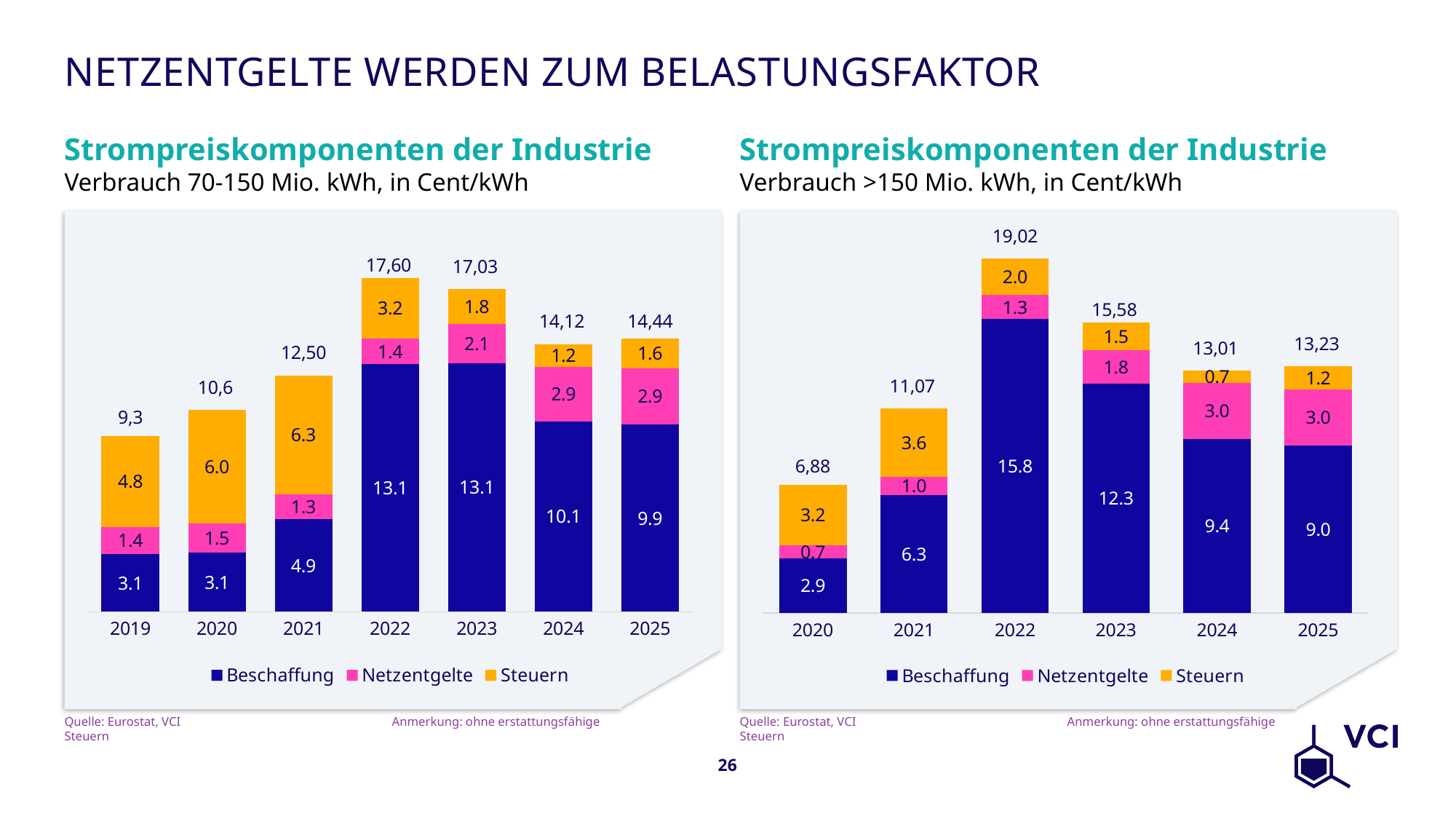
In the right chart (Verbrauch >150 Mio. kWh), which year has the highest total? 2022 In the right chart (Verbrauch >150 Mio. kWh), which colour represents Netzentgelte in the legend? Pink In the right chart (Verbrauch >150 Mio. kWh), what is the Netzentgelte value for 2024? 3.0 In the left chart (Verbrauch 70-150 Mio. kWh), does the Steuern value rise or fall from 2021 to 2024? Fall In the left chart (Verbrauch 70-150 Mio. kWh), what is the total shown above the 2023 bar? 17,03 In the left chart (Verbrauch 70-150 Mio. kWh), what is the Beschaffung value for 2022? 13.1 What kind of chart is the right chart (Verbrauch >150 Mio. kWh)? Stacked bar chart How many years are shown on the x axis of the right chart (Verbrauch >150 Mio. kWh)? 6 In the left chart (Verbrauch 70-150 Mio. kWh), is the Steuern value larger in 2020 or in 2024? 2020 How many series does the legend of the left chart (Verbrauch 70-150 Mio. kWh) list? 3 In the left chart (Verbrauch 70-150 Mio. kWh), which year has the lowest total? 2019 In the right chart (Verbrauch >150 Mio. kWh), what is the difference between the Steuern values for 2021 and 2025? 2.4